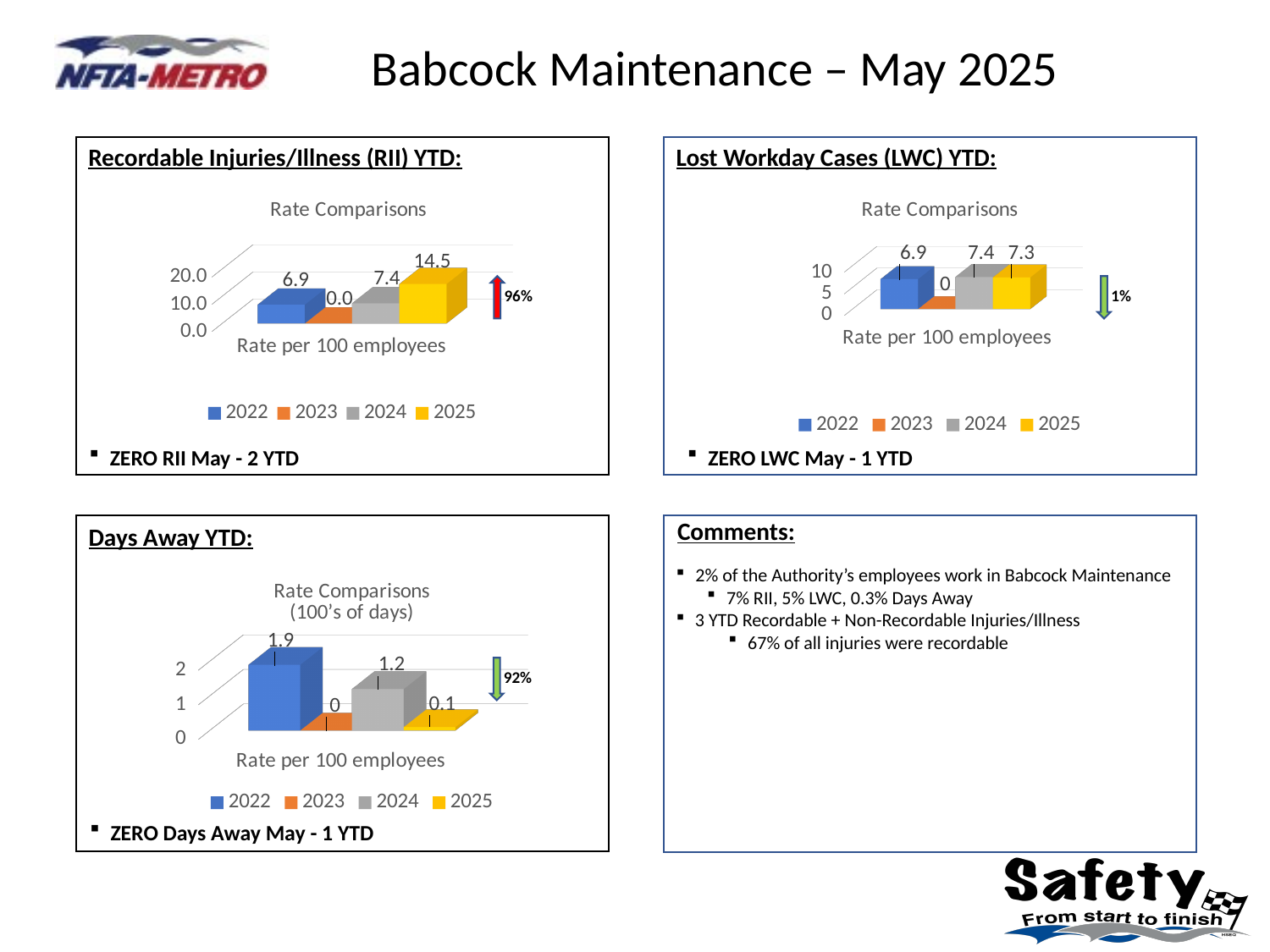
In the Lost Workday Cases (LWC) YTD chart, is the value for 2022 greater or less than 5? greater In the Recordable Injuries/Illness (RII) YTD chart, which year has the highest value? 2025 In the Lost Workday Cases (LWC) YTD chart, what is the value for 2024? 7.4 In the Days Away YTD chart, what is the value for 2022? 1.9 What is the x-axis category label shown in the Lost Workday Cases (LWC) YTD chart? Rate per 100 employees What kind of chart is the Days Away YTD chart? Bar chart In the Days Away YTD chart, what is the difference between the 2022 and 2024 values? 0.7 In the Recordable Injuries/Illness (RII) YTD chart, what is the difference between the 2025 and 2024 values? 7.1 In the Recordable Injuries/Illness (RII) YTD chart, what is the value for 2025? 14.5 In the Lost Workday Cases (LWC) YTD chart, which year has the lowest value? 2023 In the Recordable Injuries/Illness (RII) YTD chart, how many series does the legend list? 4 In the Days Away YTD chart, which is larger, the value for 2024 or the value for 2025? 2024